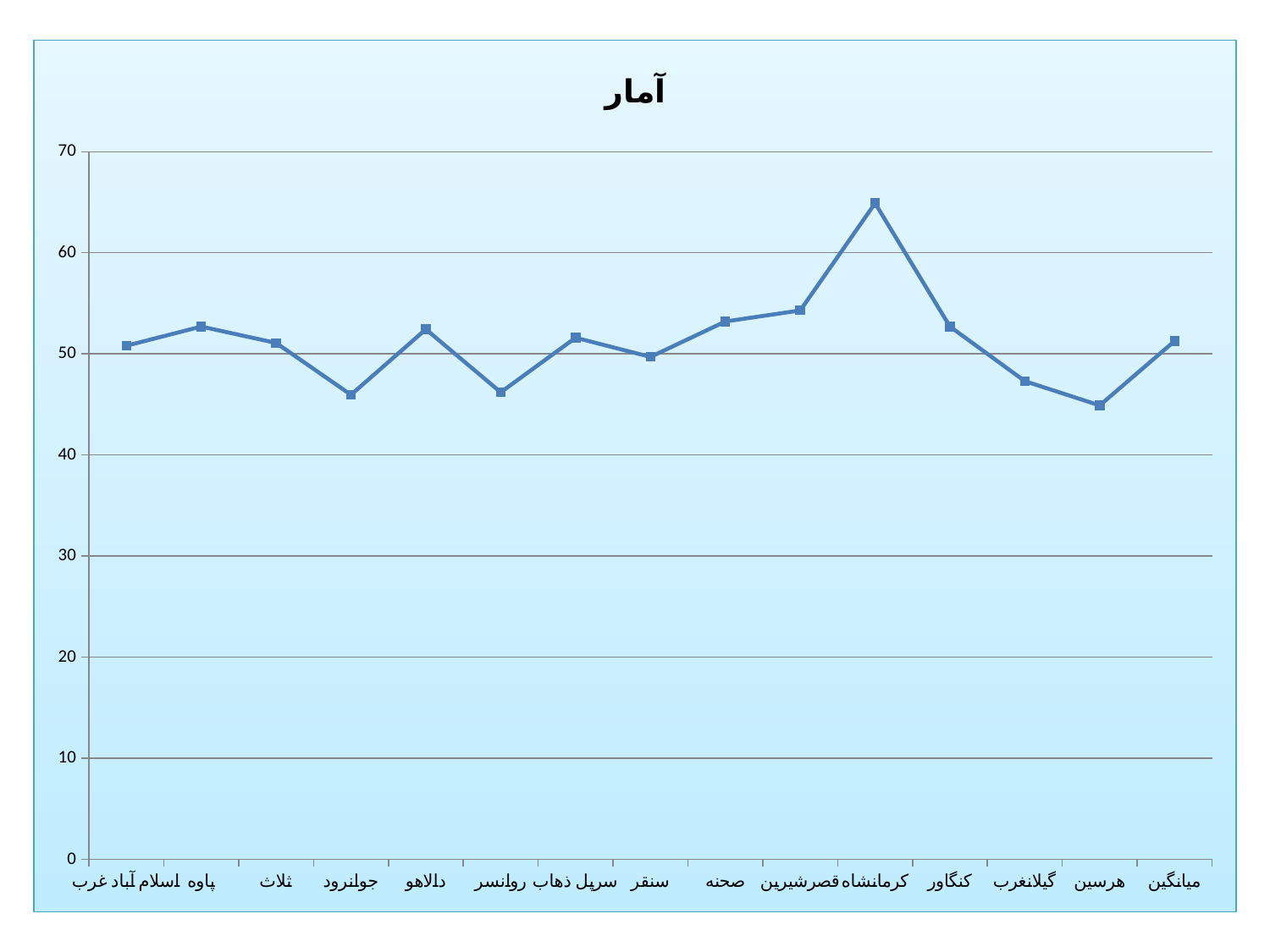
Do the values rise or fall from کرمانشاه to هرسین? fall Which category has the highest value? کرمانشاه What is the title of the chart? آمار Which is larger, the value for کرمانشاه or the value for کنگاور? کرمانشاه Is the value for جوانرود greater or less than 50? less Is the value for کرمانشاه greater or less than 60? greater Is the value for هرسین greater or less than 50? less What kind of chart is shown on the slide? line chart How many categories are plotted along the x axis? 15 Which is larger, the value for دالاهو or the value for روانسر? دالاهو